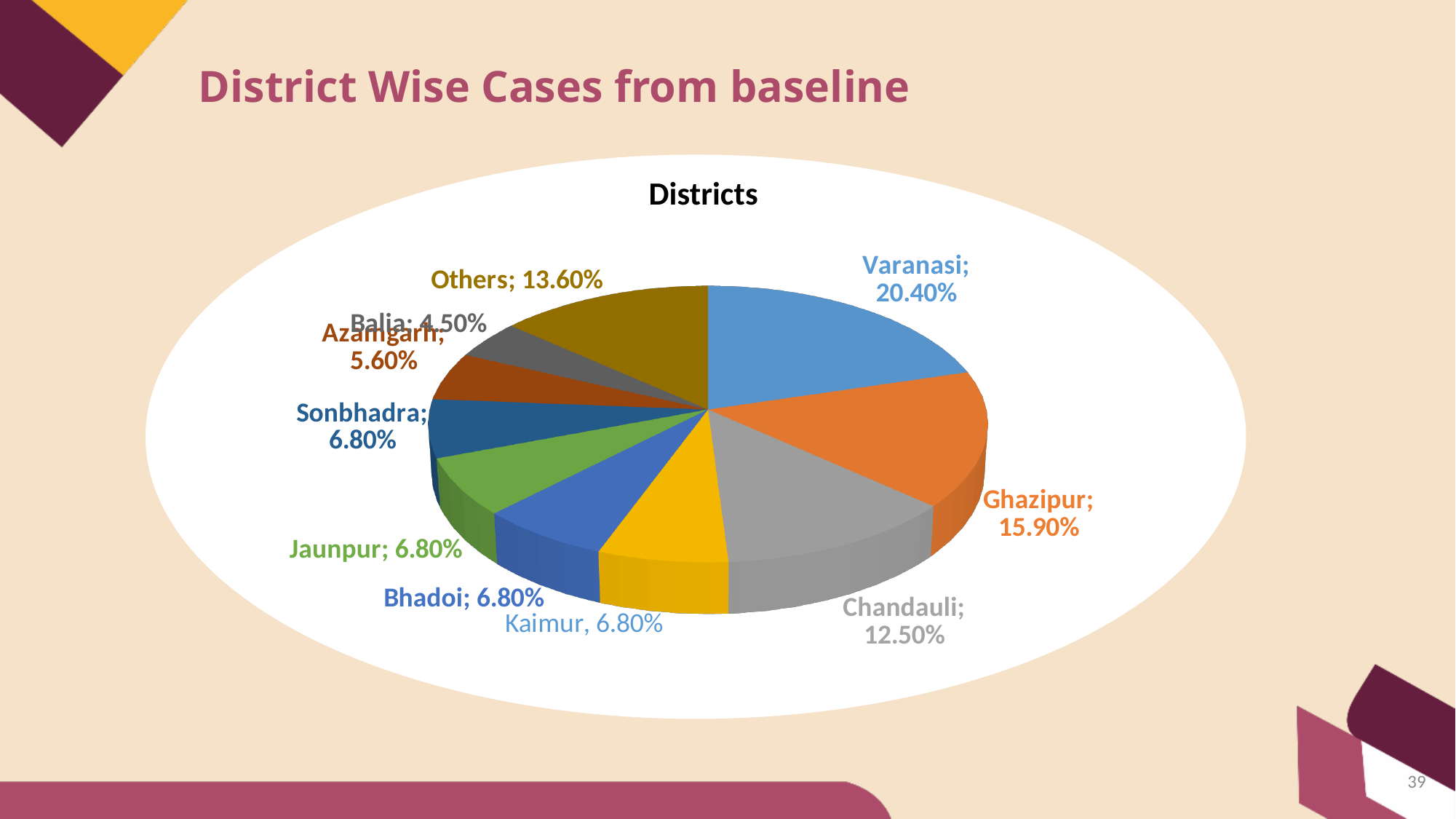
What is the chart's title? Districts Which labelled slice is the smallest? Balia Which district has the largest slice of the pie? Varanasi What kind of chart is shown on the slide? Pie chart What percentage is shown for Chandauli? 12.50% What is the difference between the Varanasi and Ghazipur percentages? 4.50% What is the value shown for Azamgarh? 5.60% What is the value shown for Ghazipur? 15.90% What is the value shown for Others? 13.60% How many slices does the pie chart have? 10 Which is larger, the share for Chandauli or the share for Others? Others What share of cases does Varanasi account for? 20.40%